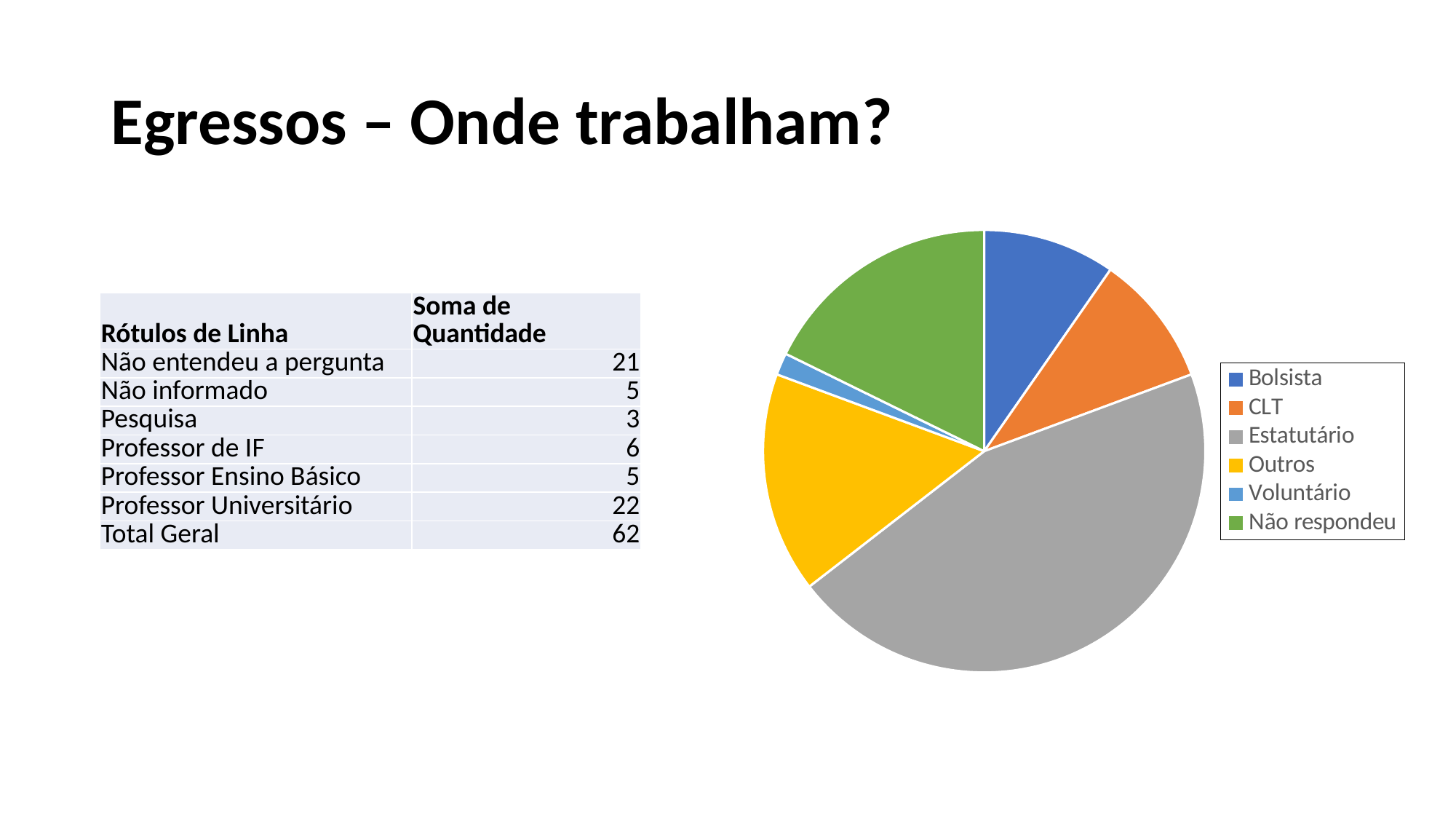
Which category has the largest slice in the pie chart? Estatutário Does the Estatutário slice take up more or less than half of the pie chart? less What kind of chart is shown on the slide? pie chart Which category does the green slice of the pie chart represent? Não respondeu Which category has the smallest slice in the pie chart? Voluntário In the pie chart, which slice is larger: Outros or Voluntário? Outros In the pie chart, which slice is larger: Estatutário or Outros? Estatutário In the pie chart, which slice is larger: Não respondeu or Bolsista? Não respondeu What colour is the Estatutário slice in the pie chart? grey How many slices does the pie chart have? 6